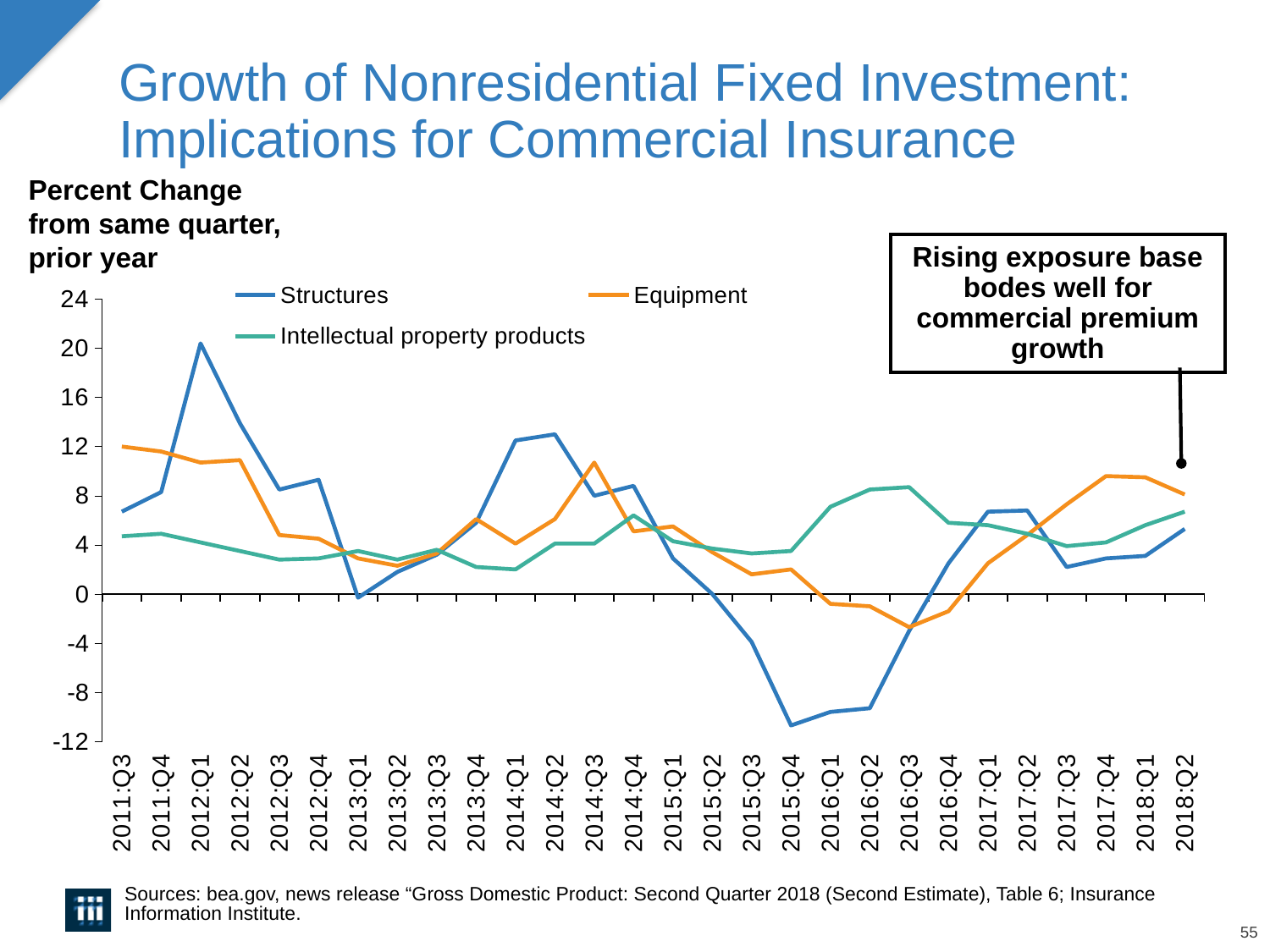
In 2012:Q1, which series has the larger value, Structures or Intellectual property products? Structures How many quarters are plotted along the x axis? 28 Is the value for Structures in 2015:Q4 greater or less than -8? less In 2015:Q4, which series has the larger value, Structures or Equipment? Equipment In which quarter does the Structures series reach its highest value? 2012:Q1 What kind of chart is shown on the slide? line chart Is the value for Equipment in 2011:Q3 greater or less than 8? greater How many series does the legend list? 3 Does the Structures series rise or fall from 2014:Q2 to 2015:Q4? fall Which series is drawn in orange? Equipment Is the value for Structures in 2012:Q1 greater or less than 16? greater In which quarter does the Structures series reach its lowest value? 2015:Q4